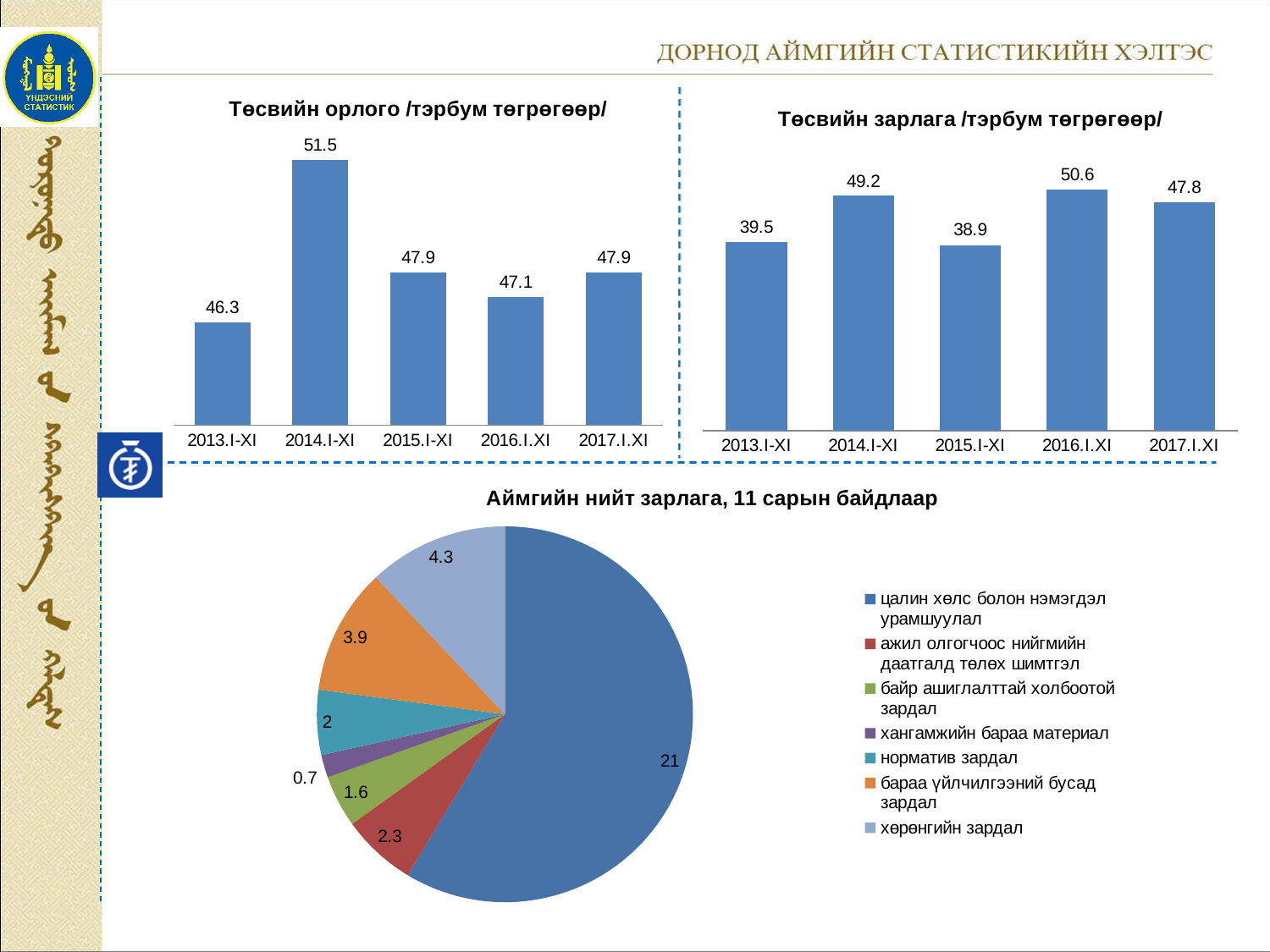
In the chart titled 'Төсвийн зарлага /тэрбум төгрөгөөр/', what is the difference between the values for 2016.I.XI and 2017.I.XI? 2.8 In the chart titled 'Төсвийн орлого /тэрбум төгрөгөөр/', what is the value for 2014.I-XI? 51.5 In the chart titled 'Төсвийн орлого /тэрбум төгрөгөөр/', which category has the lowest value? 2013.I-XI In the chart titled 'Төсвийн орлого /тэрбум төгрөгөөр/', how many categories are shown on the x axis? 5 What kind of chart is the chart titled 'Төсвийн зарлага /тэрбум төгрөгөөр/'? bar chart In the chart titled 'Төсвийн зарлага /тэрбум төгрөгөөр/', what is the value for 2016.I.XI? 50.6 In the pie chart titled 'Аймгийн нийт зарлага, 11 сарын байдлаар', which slice is the largest? цалин хөлс болон нэмэгдэл урамшуулал In the chart titled 'Төсвийн орлого /тэрбум төгрөгөөр/', what is the difference between the values for 2014.I-XI and 2013.I-XI? 5.2 In the chart titled 'Төсвийн зарлага /тэрбум төгрөгөөр/', which is larger, the value for 2013.I-XI or the value for 2015.I-XI? 2013.I-XI In the pie chart titled 'Аймгийн нийт зарлага, 11 сарын байдлаар', how many entries does the legend list? 7 In the chart titled 'Төсвийн зарлага /тэрбум төгрөгөөр/', which category has the highest value? 2016.I.XI In the pie chart titled 'Аймгийн нийт зарлага, 11 сарын байдлаар', what is the value for 'хөрөнгийн зардал'? 4.3